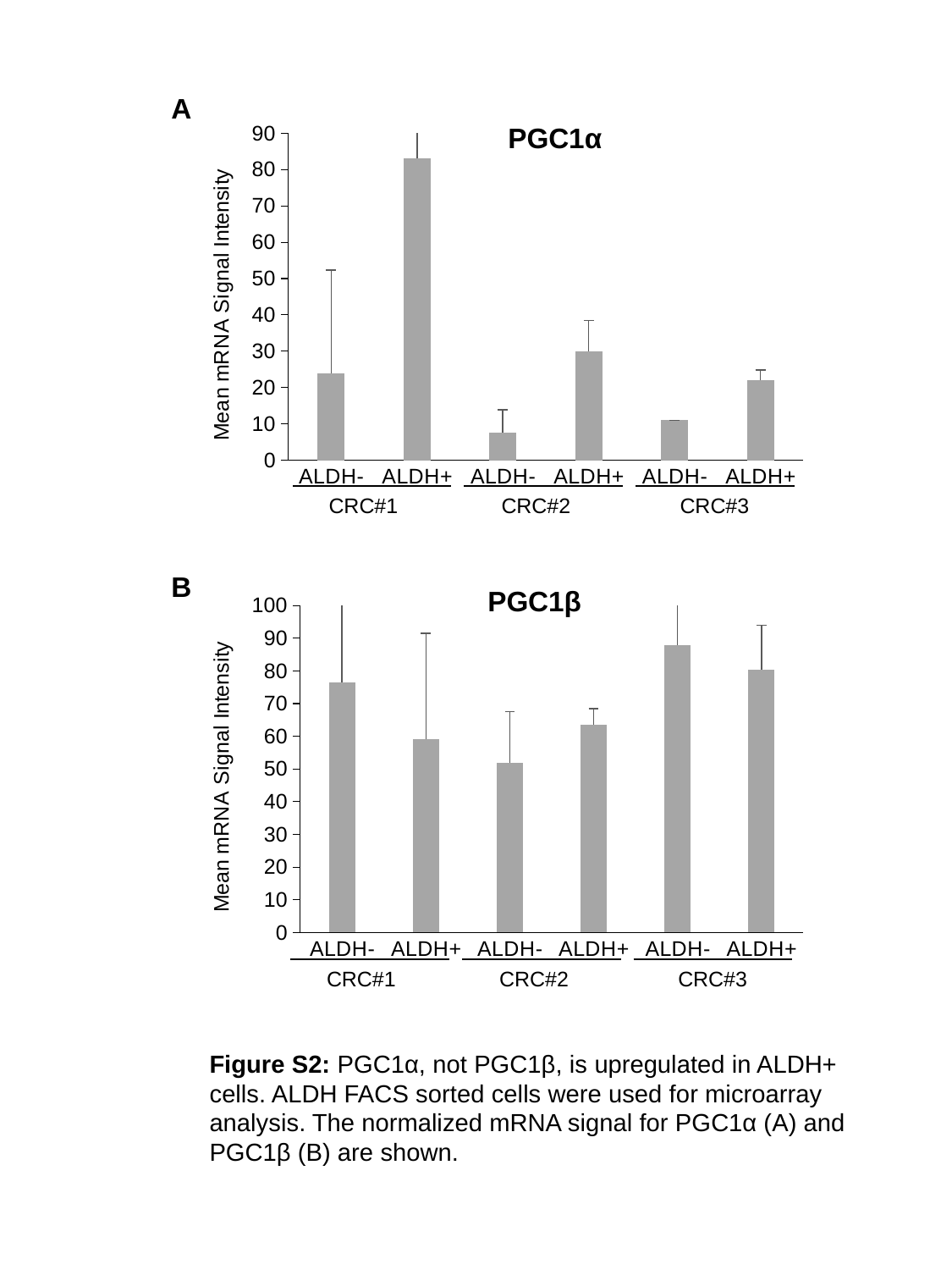
In the PGC1β chart (panel B), for CRC#1, which is larger: ALDH- or ALDH+? ALDH- In the PGC1α chart (panel A), is the value for ALDH+ in CRC#1 greater or less than 70? greater In the PGC1α chart (panel A), how many bars are plotted? 6 In the PGC1β chart (panel B), which bar is the lowest? ALDH- in CRC#2 In the PGC1α chart (panel A), which bar is the highest? ALDH+ in CRC#1 In the PGC1α chart (panel A), for CRC#2, which is larger: ALDH- or ALDH+? ALDH+ In the PGC1α chart (panel A), which bar is the lowest? ALDH- in CRC#2 In the PGC1α chart (panel A), is the value for ALDH- in CRC#3 greater or less than 20? less In the PGC1β chart (panel B), is the value for ALDH- in CRC#1 greater or less than 70? greater What kind of chart is the PGC1α chart (panel A)? bar chart In the PGC1β chart (panel B), which bar is the highest? ALDH- in CRC#3 What is the y-axis label of the PGC1β chart (panel B)? Mean mRNA Signal Intensity